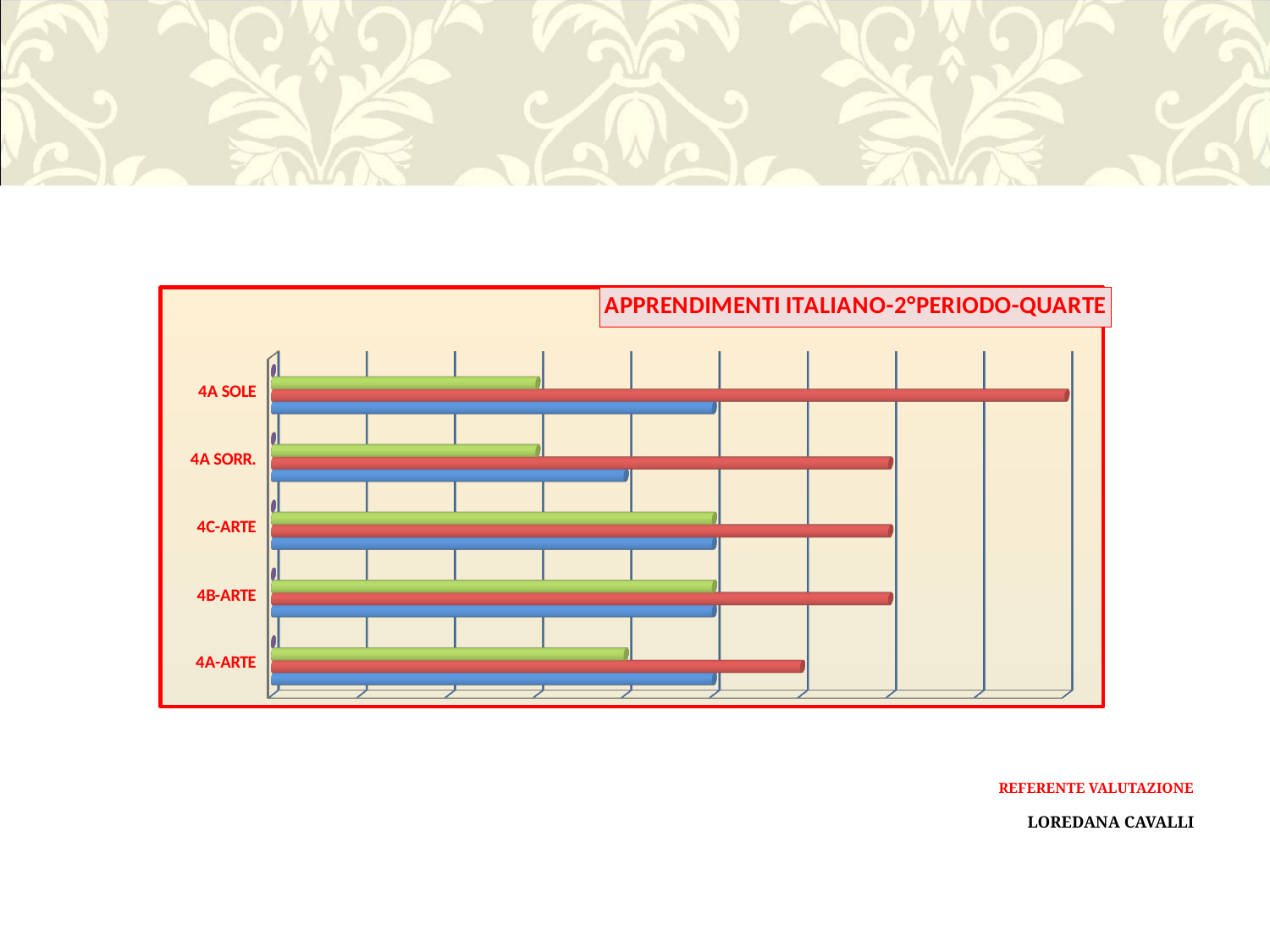
Which is longer, the red bar for 4A SOLE or the red bar for 4A SORR.? 4A SOLE Which category has the longest red bar? 4A SOLE Which category label appears at the top of the chart's vertical axis? 4A SOLE Which category has the shortest blue bar? 4A SORR. Which category has the shortest red bar? 4A-ARTE What kind of chart is shown on the slide? bar chart How many categories (classes) are shown on the chart's vertical axis? 5 Which is longer, the green bar for 4C-ARTE or the green bar for 4A SOLE? 4C-ARTE What is the title of the chart? APPRENDIMENTI ITALIANO-2°PERIODO-QUARTE Which is longer, the green bar for 4A-ARTE or the green bar for 4A SORR.? 4A-ARTE How many bars are plotted for each category on the chart? 3